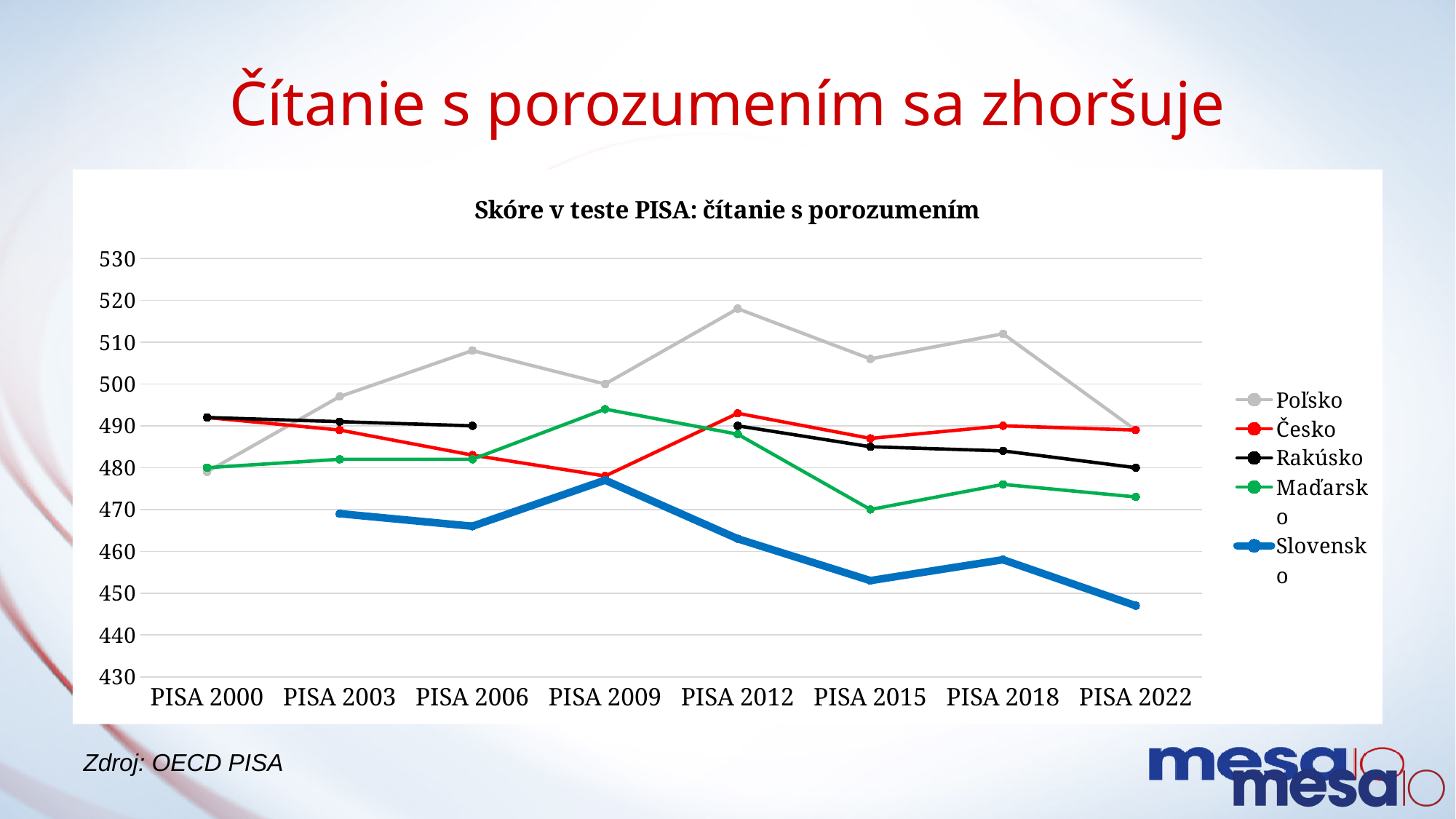
How many PISA rounds are shown on the x axis? 8 Is the value for Maďarsko at PISA 2009 greater or less than 490? greater In which PISA round does Slovensko reach its highest score? PISA 2009 Does the value for Rakúsko rise or fall from PISA 2012 to PISA 2022? fall Is the value for Slovensko at PISA 2022 greater or less than 450? less At PISA 2015, which is larger: the value for Maďarsko or for Slovensko? Maďarsko How many series does the legend list? 5 Which country has the lowest score at PISA 2022? Slovensko What kind of chart is shown on the slide? line chart Which country has the highest score at PISA 2012? Poľsko What is the title of the chart? Skóre v teste PISA: čítanie s porozumením Is the value for Poľsko at PISA 2012 greater or less than 510? greater